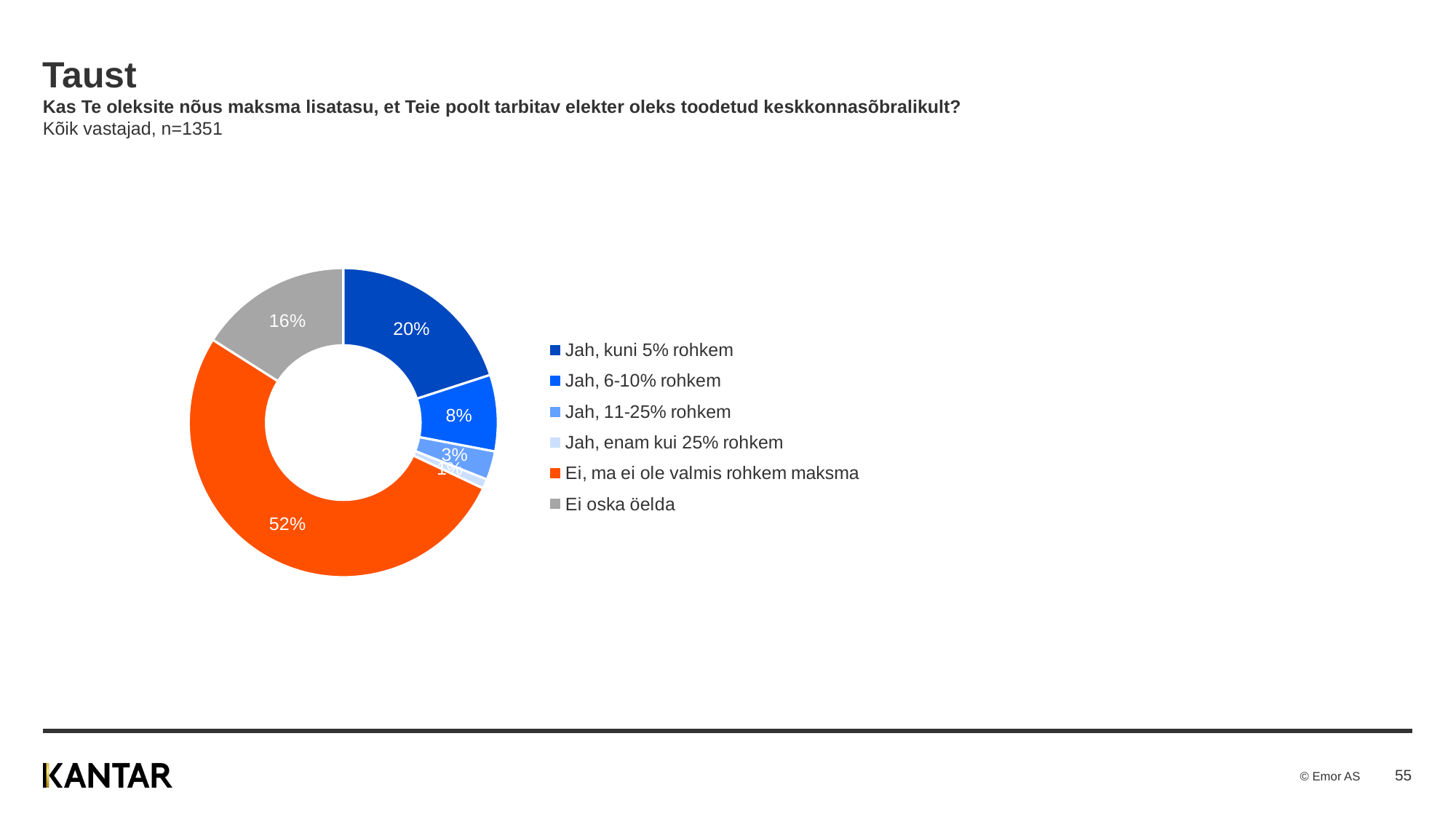
What percentage of respondents answered "Ei oska öelda"? 16% Which response category has the largest share of the pie? Ei, ma ei ole valmis rohkem maksma What percentage of respondents answered "Jah, kuni 5% rohkem"? 20% Which is larger: the share for "Ei oska öelda" or the share for "Jah, 6-10% rohkem"? Ei oska öelda What percentage of respondents answered "Jah, 6-10% rohkem"? 8% What kind of chart is shown on the slide? Pie chart (donut) What share of the pie does "Jah, 11-25% rohkem" take? 3% What is the difference in percentage points between "Ei, ma ei ole valmis rohkem maksma" and "Jah, kuni 5% rohkem"? 32 percentage points Which response category has the smallest share of the pie? Jah, enam kui 25% rohkem What colour is the slice for "Ei, ma ei ole valmis rohkem maksma"? Orange How many response categories does the chart show? 6 What percentage of respondents answered "Ei, ma ei ole valmis rohkem maksma"? 52%